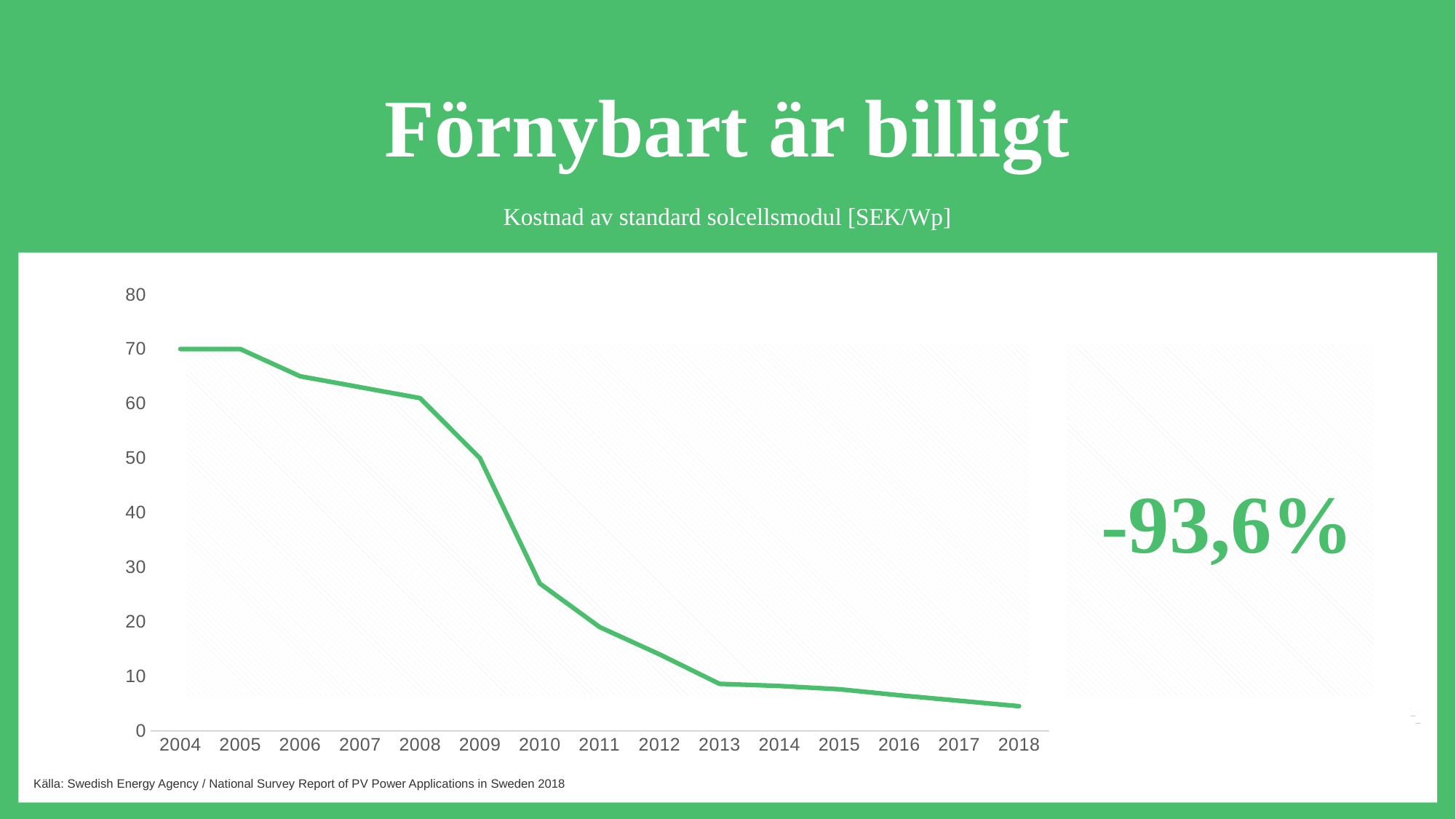
Do the values in the chart rise or fall from 2004 to 2018? fall Is the value for 2006 greater or less than 60? greater What is the title of the chart? Kostnad av standard solcellsmodul [SEK/Wp] How many years are plotted along the x axis of the chart? 15 Which year has the larger value, 2008 or 2010? 2008 Is the value for 2012 greater or less than 10? greater Is the value for 2010 greater or less than 30? less What percentage change is printed to the right of the chart? -93,6% Which year has the lowest value in the chart? 2018 What kind of chart is shown on the slide? line chart